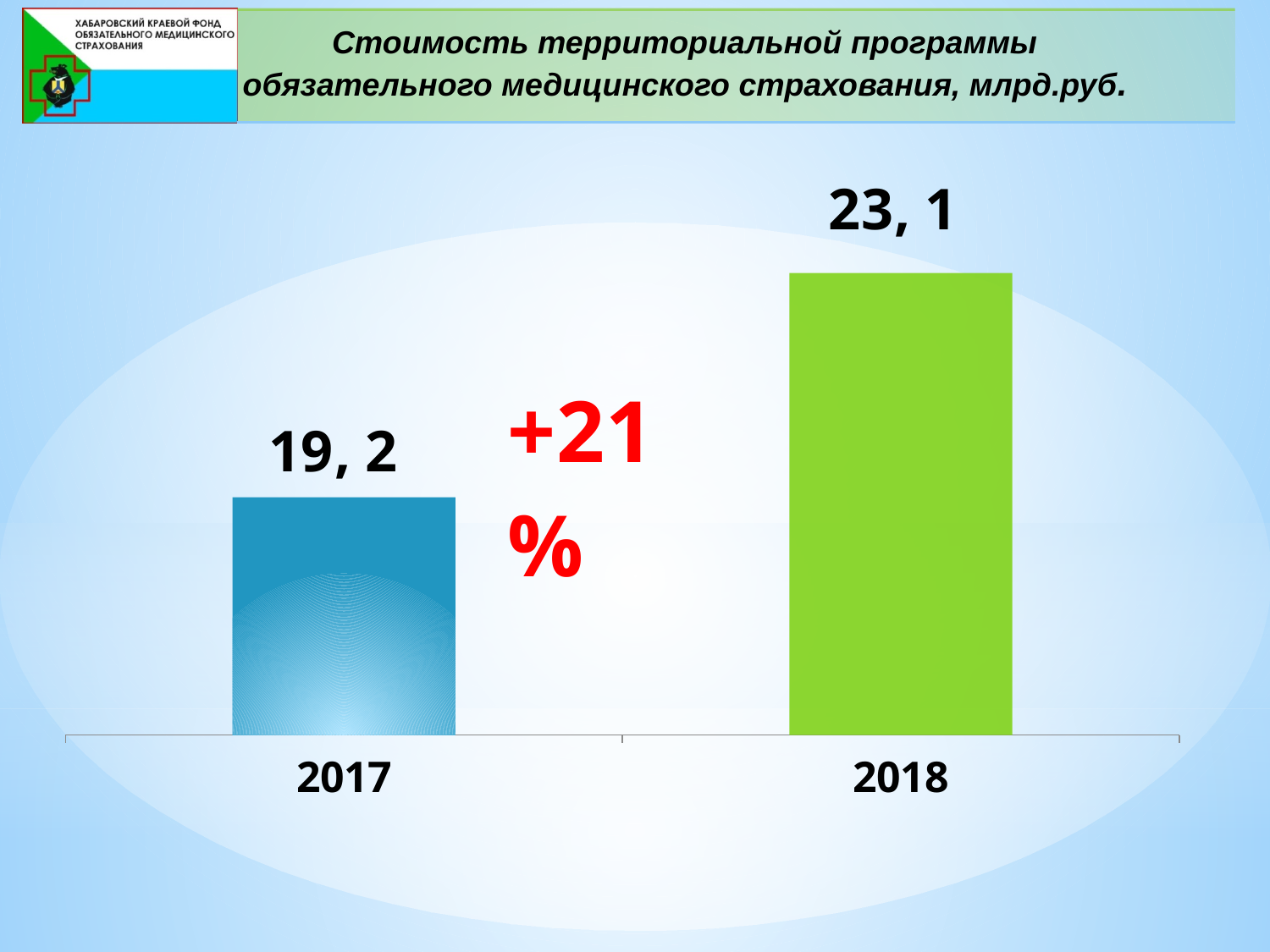
Which year has the lower value? 2017 What is the difference between the 2018 and 2017 values? 3,9 Do the values rise or fall from 2017 to 2018? Rise What colour is the bar for 2018? Green What is the value for 2018? 23, 1 What percentage change is printed in red between the two bars? +21 % How many categories are shown on the x axis? 2 Which year has the higher value? 2018 Is the value for 2018 larger than the value for 2017? Yes What kind of chart is shown on the slide? Bar chart What is the value for 2017? 19, 2